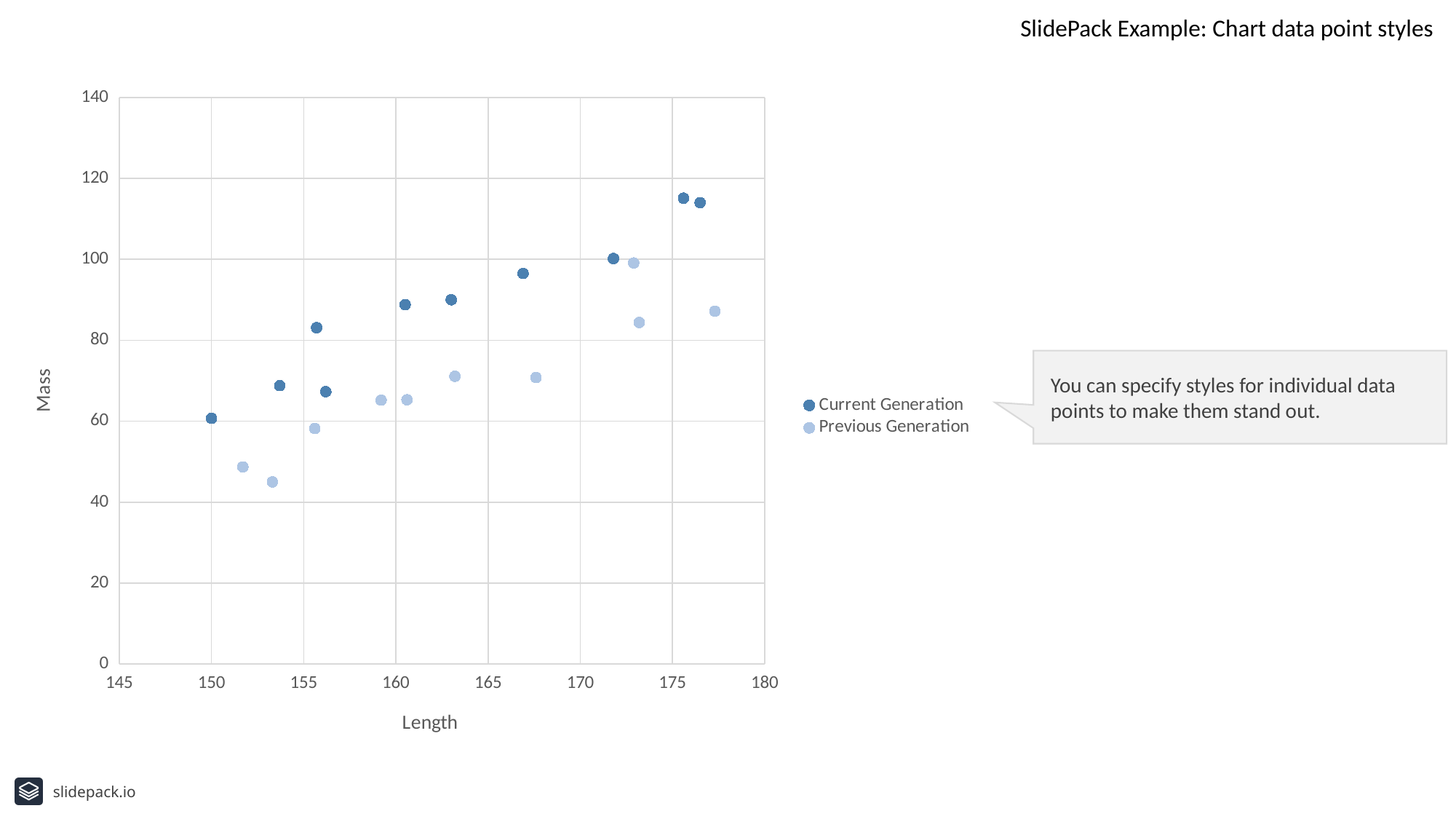
Which series contains the point with the lowest Mass on the chart? Previous Generation Is the Mass of the highest Current Generation point greater or less than 100? greater Is the Mass of the Current Generation point at Length 150 greater or less than 80? less What are the two series named in the chart legend? Current Generation and Previous Generation What kind of chart is shown on the slide? scatter chart Do the Mass values generally rise or fall as Length increases along the x axis? rise How many Current Generation points are plotted on the chart? 10 What is the title of the vertical axis of the chart? Mass Is the Mass of the lowest Previous Generation point greater or less than 60? less How many series does the chart legend list? 2 Which series contains the point with the highest Mass on the chart? Current Generation